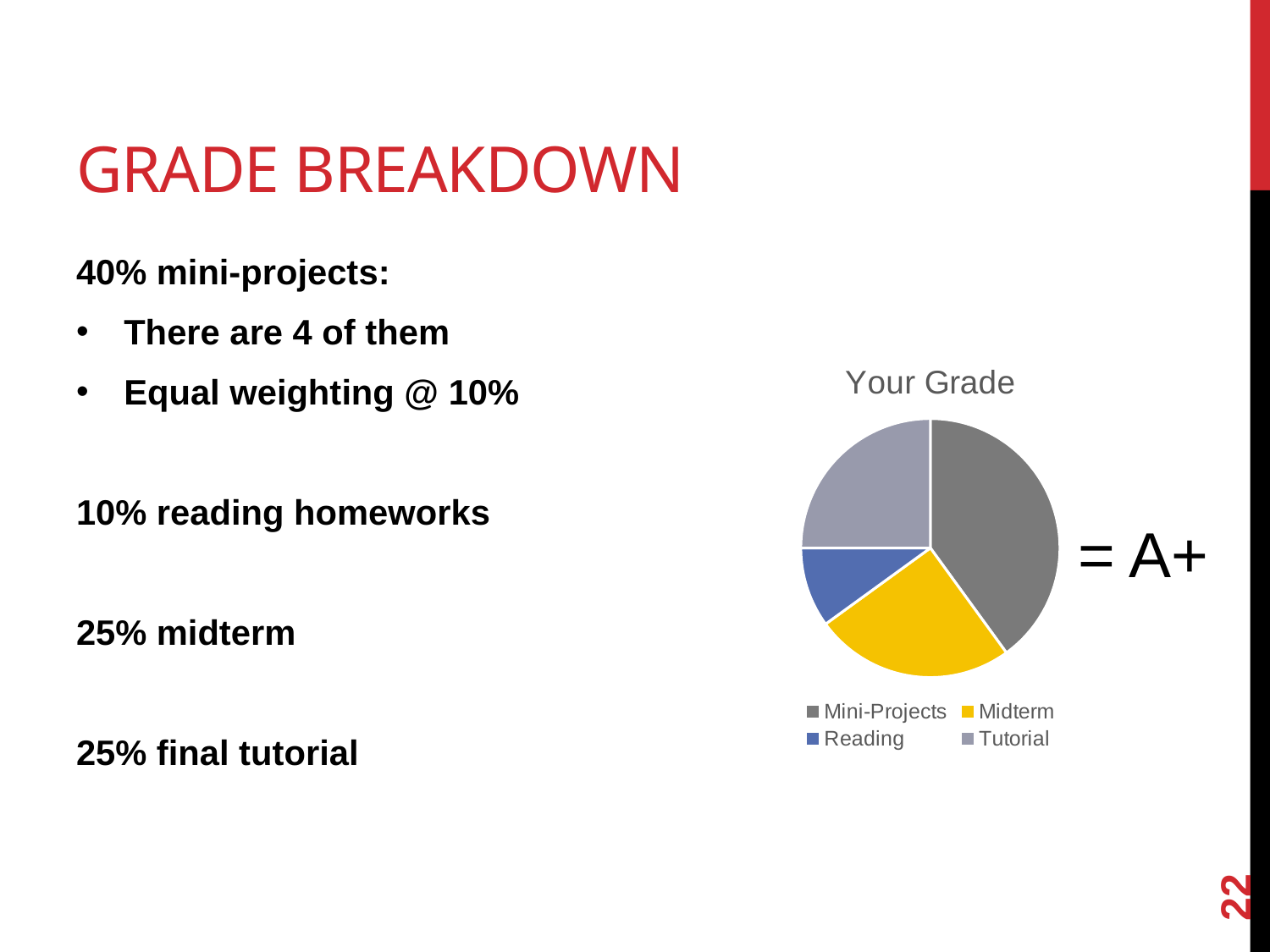
How many slices does the pie chart have? 4 What share of the grade does the Mini-Projects slice represent, according to the slide? 40% What colour is the Midterm slice in the pie chart? yellow Which slice of the pie chart is the smallest? Reading What kind of chart is shown on the slide? pie chart What is the title of the chart? Your Grade What share of the grade does the Reading slice represent, according to the slide? 10% Which is larger in the pie chart, the Mini-Projects slice or the Midterm slice? Mini-Projects Which is larger in the pie chart, the Reading slice or the Tutorial slice? Tutorial How many entries does the chart legend list? 4 Which slice of the pie chart is the largest? Mini-Projects What share of the grade does the Midterm slice represent, according to the slide? 25%